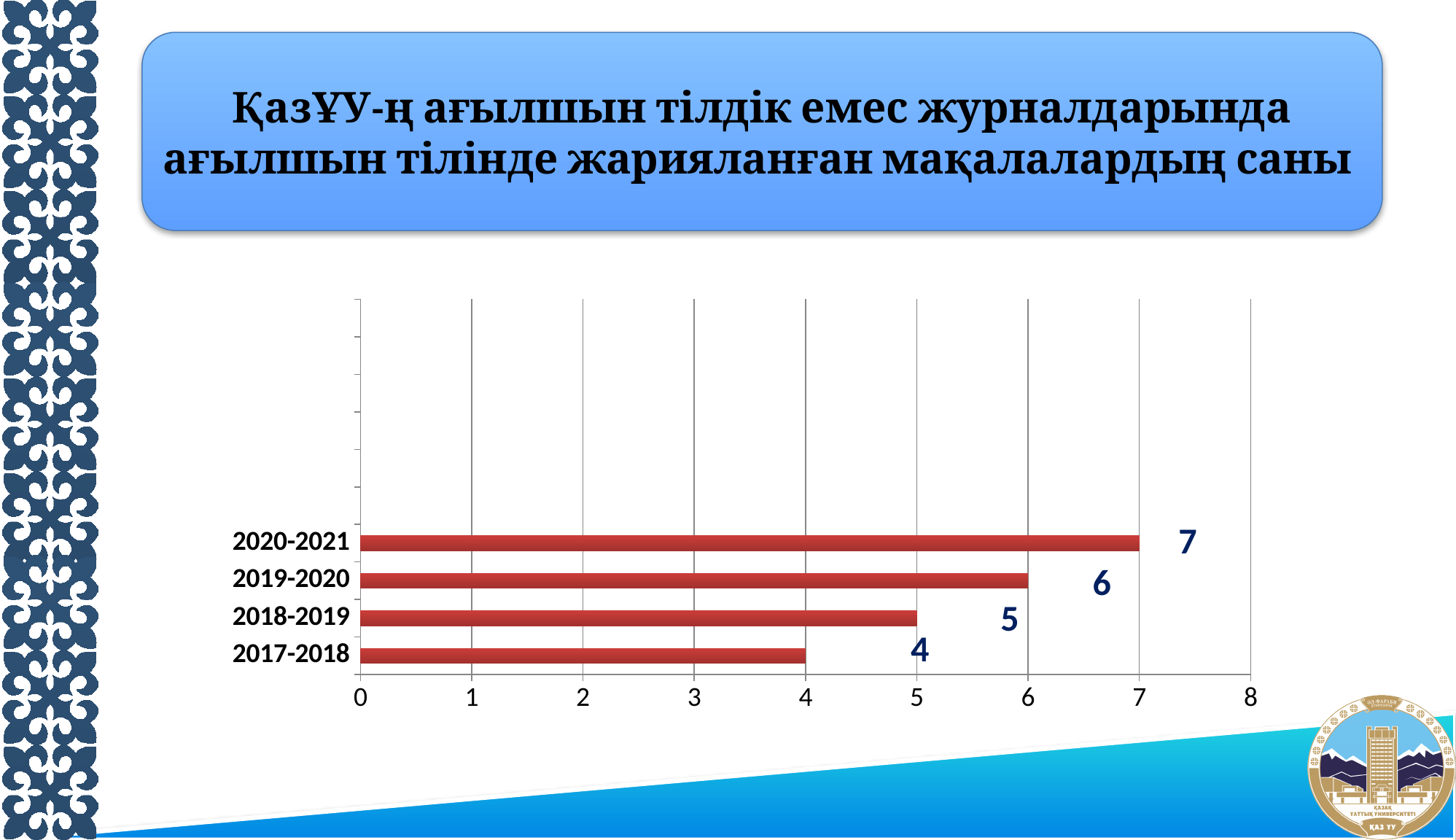
What kind of chart is shown on the slide? bar chart What colour are the bars in the chart? red What is the value for 2020-2021? 7 Which category has the highest value? 2020-2021 What is the value for 2017-2018? 4 What is the value for 2018-2019? 5 Is the value for 2019-2020 greater or less than 5? greater What is the difference between the values for 2020-2021 and 2017-2018? 3 Which is larger, the value for 2019-2020 or the value for 2018-2019? 2019-2020 Which category has the lowest value? 2017-2018 How many categories are shown in the chart? 4 Do the values rise or fall from 2017-2018 to 2020-2021? rise